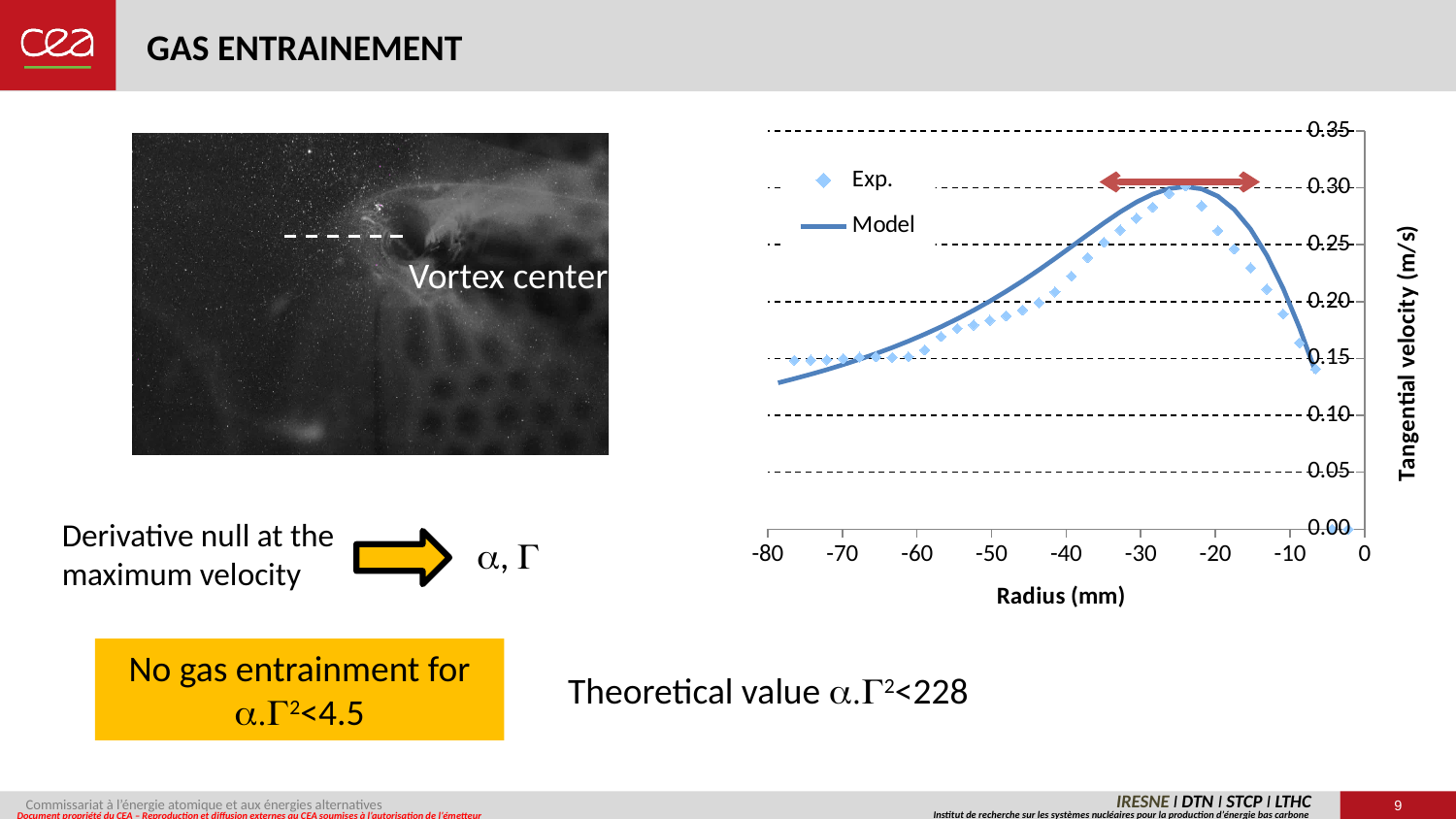
What is the title of the y axis of the chart? Tangential velocity (m/s) Is the Model value at a radius of -80 mm greater or less than 0.15? less Between a radius of -20 mm and -10 mm, does the Model curve rise or fall? fall Is the Model value at a radius of -30 mm greater or less than 0.25? greater Is the Model value at a radius of -60 mm greater or less than 0.15? greater What is the maximum value shown on the y axis of the chart? 0.35 How many series does the chart legend list? 2 What is the minimum value shown on the x axis of the chart? -80 What are the two series named in the chart legend? Exp. and Model Between a radius of -80 mm and -30 mm, does the Model curve rise or fall? rise What is the title of the x axis of the chart? Radius (mm) Which series is drawn as a solid line rather than markers? Model